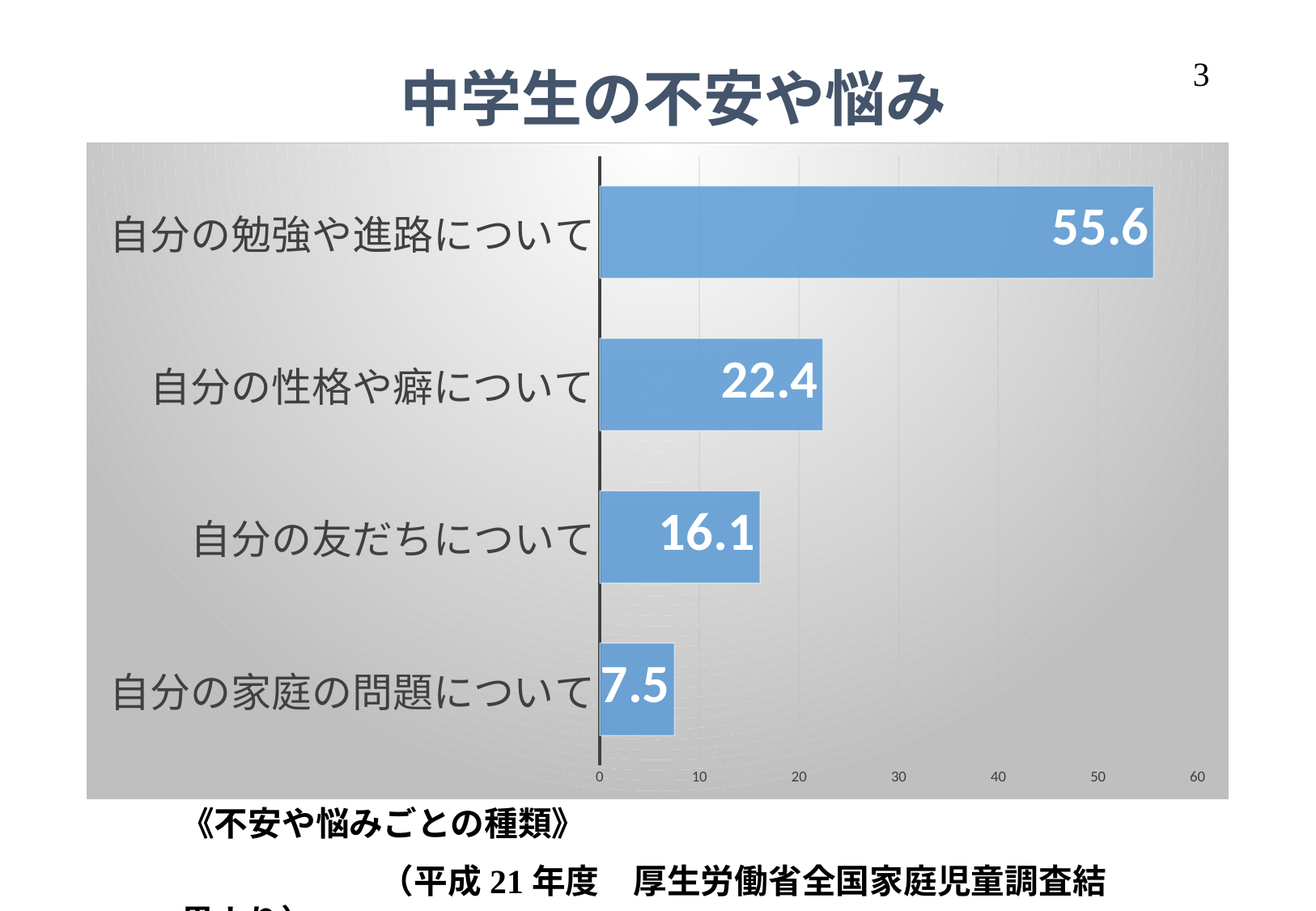
What is the value for 自分の友だちについて? 16.1 What is the value for 自分の家庭の問題について? 7.5 What is the value for 自分の性格や癖について? 22.4 Which category has the lowest value? 自分の家庭の問題について What is the difference between the values for 自分の勉強や進路について and 自分の性格や癖について? 33.2 Which is larger, the value for 自分の性格や癖について or the value for 自分の友だちについて? 自分の性格や癖について What is the title of the slide above the chart? 中学生の不安や悩み What is the value for 自分の勉強や進路について? 55.6 What is the difference between the values for 自分の友だちについて and 自分の家庭の問題について? 8.6 How many categories are shown in the chart? 4 Which category has the highest value? 自分の勉強や進路について What kind of chart is shown on the slide? bar chart